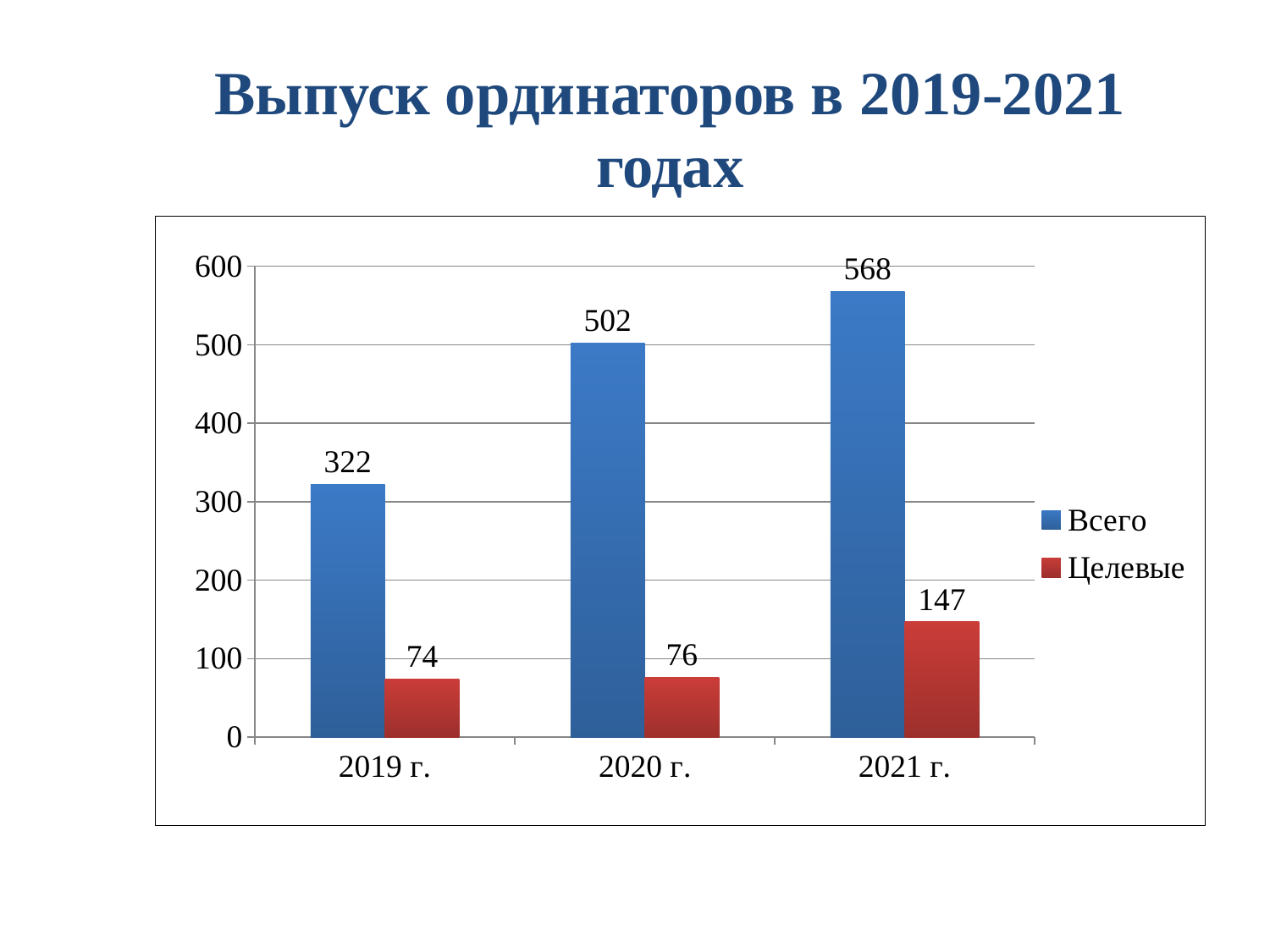
What is the difference between Всего in 2021 г. and Всего in 2020 г.? 66 What is the value of Целевые for 2021 г.? 147 Which is larger: Целевые in 2021 г. or Целевые in 2019 г.? Целевые in 2021 г. What is the value of Всего for 2019 г.? 322 What kind of chart is shown on the slide? bar chart Which year has the highest value for Всего? 2021 г. Is the value of Всего for 2020 г. greater or less than 400? greater What is the value of Целевые for 2020 г.? 76 How many years are shown on the x axis? 3 What is the difference between Всего and Целевые in 2019 г.? 248 How many series does the legend list? 2 Which year has the lowest value for Целевые? 2019 г.